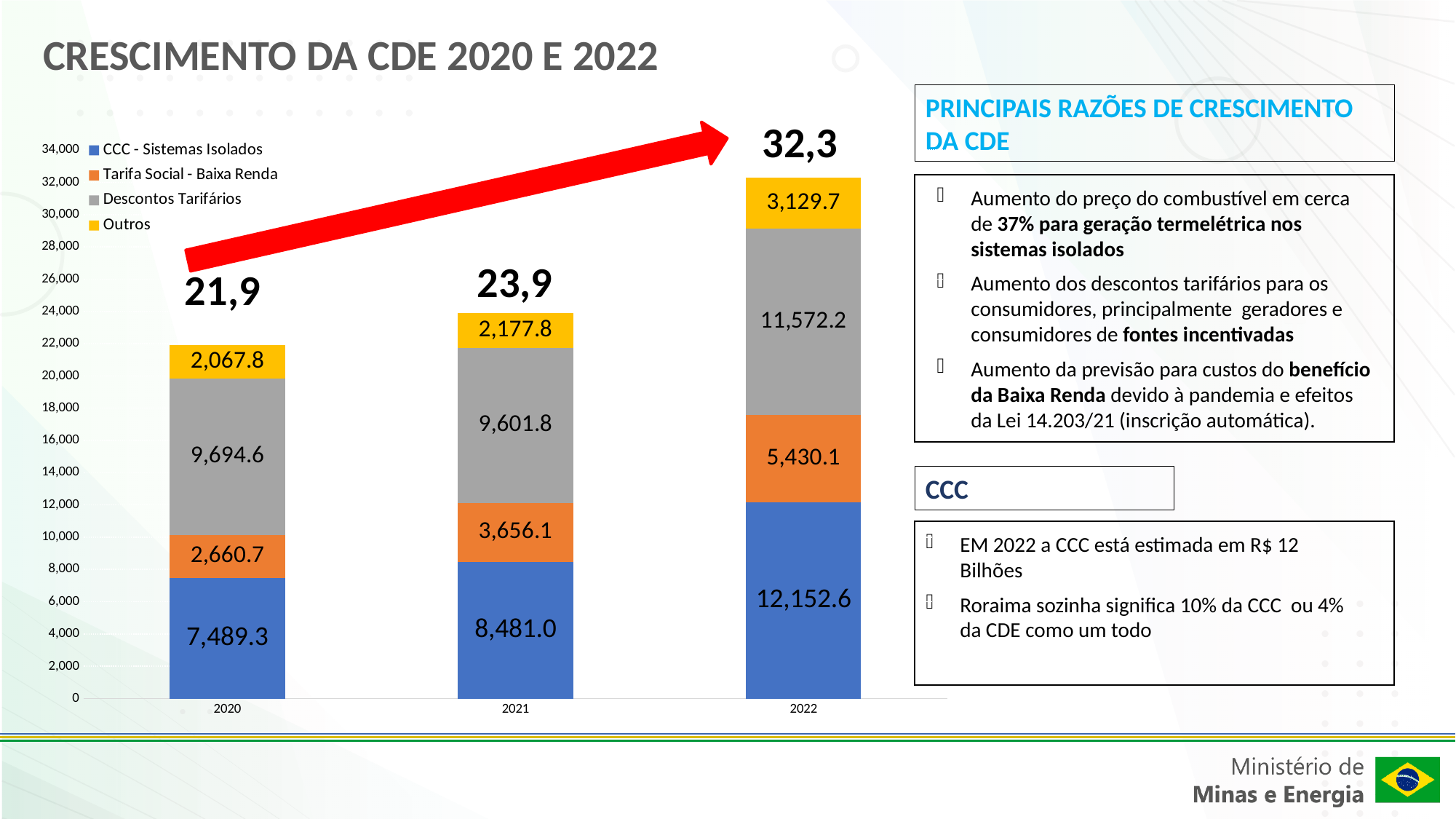
What is the value of Tarifa Social - Baixa Renda for 2021? 3,656.1 Which is larger: Descontos Tarifários in 2020 or in 2021? 2020 What kind of chart is shown on the slide? Stacked bar chart What is the value of Descontos Tarifários for 2020? 9,694.6 In which year is the CCC - Sistemas Isolados value highest? 2022 What is the value of Outros for 2022? 3,129.7 What total label is printed above the 2022 bar? 32,3 How many years are shown on the x axis? 3 What is the difference between the CCC - Sistemas Isolados values for 2022 and 2020? 4,663.3 How many series does the legend list? 4 What is the value of CCC - Sistemas Isolados for 2022? 12,152.6 In which year is the Outros value lowest? 2020